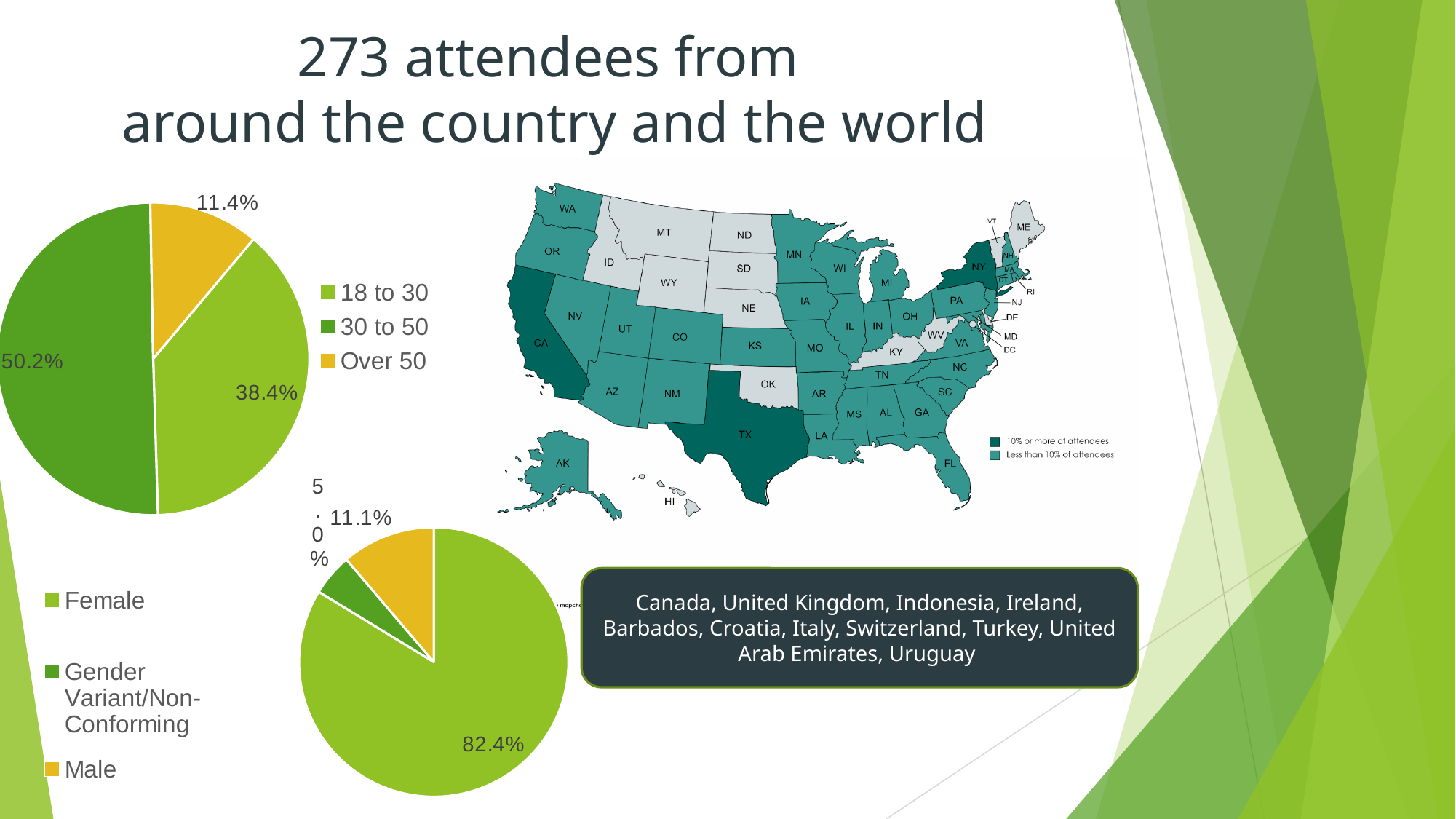
In the gender pie chart at the bottom, which category has the smallest share? Gender Variant/Non-Conforming In the age pie chart on the upper left, what is the difference between the 30 to 50 share and the 18 to 30 share? 11.8% In the gender pie chart at the bottom, what share of attendees are Female? 82.4% How many categories does the legend of the age pie chart on the upper left list? 3 In the age pie chart on the upper left, which age group has the smallest share? Over 50 In the gender pie chart at the bottom, what share of attendees are Male? 11.1% In the age pie chart on the upper left, what share of attendees are 30 to 50? 50.2% In the age pie chart on the upper left, which age group has the largest share? 30 to 50 What type of chart is used to show the gender breakdown at the bottom of the slide? Pie chart In the gender pie chart at the bottom, which is larger: the Male share or the Gender Variant/Non-Conforming share? Male In the age pie chart on the upper left, what share of attendees are 18 to 30? 38.4% In the age pie chart on the upper left, what share of attendees are Over 50? 11.4%